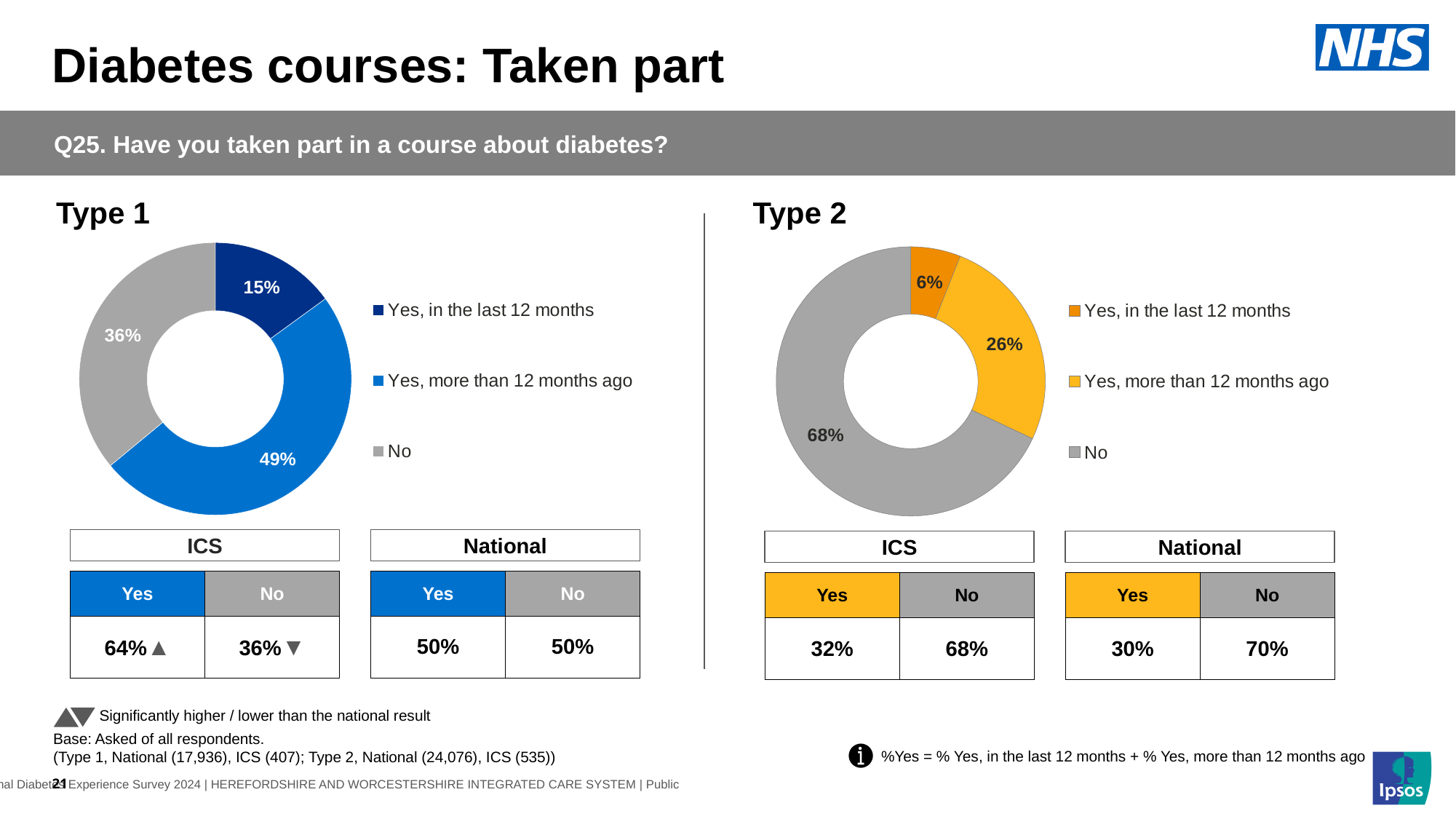
What colour represents 'No' in the Type 2 chart? Grey How many categories does the Type 2 chart show? 3 In the Type 2 chart, what is the difference between the 'No' share and the 'Yes, more than 12 months ago' share? 42 percentage points In the Type 2 chart, which category has the smallest share? Yes, in the last 12 months What kind of chart is used to show the Type 1 results? Doughnut chart In the Type 1 chart, which category has the largest share? Yes, more than 12 months ago In the Type 1 chart, what percentage of respondents said 'Yes, in the last 12 months'? 15% In the Type 1 chart, what is the combined share of the two 'Yes' categories? 64% In the Type 1 chart, which is larger: the 'No' share or the 'Yes, more than 12 months ago' share? Yes, more than 12 months ago In the Type 2 chart, what percentage of respondents said 'No'? 68% In the Type 2 chart, what percentage of respondents said 'Yes, in the last 12 months'? 6% In the Type 1 chart, what percentage of respondents said 'Yes, more than 12 months ago'? 49%